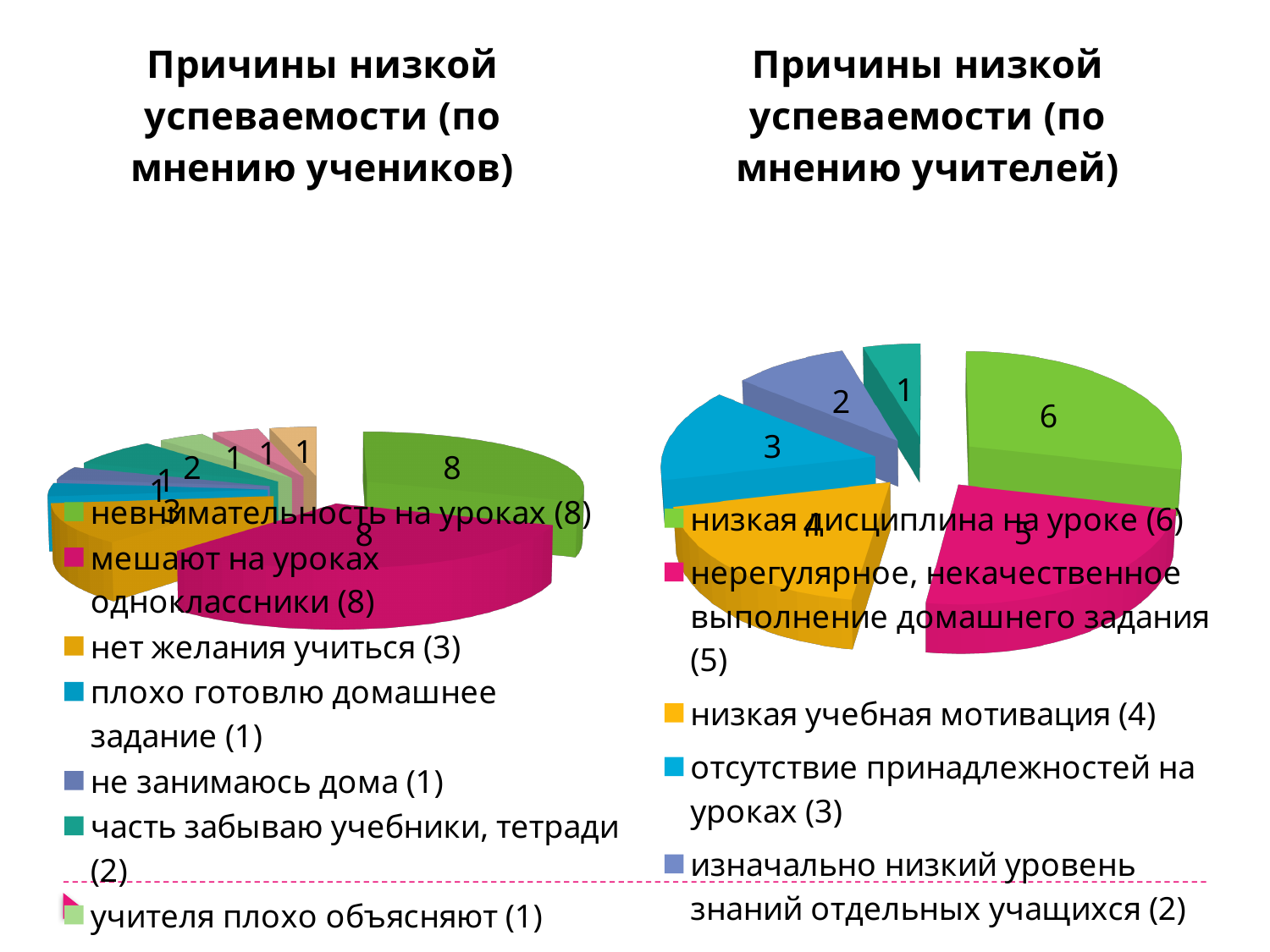
What is the title of the chart on the left side of the slide? Причины низкой успеваемости (по мнению учеников) In the chart titled 'Причины низкой успеваемости (по мнению учителей)', what is the difference between 'низкая дисциплина на уроке' and 'отсутствие принадлежностей на уроках'? 3 What kind of chart is the chart on the right side of the slide? pie chart In the chart titled 'Причины низкой успеваемости (по мнению учеников)', what is the difference between 'невнимательность на уроках' and 'нет желания учиться'? 5 In the chart titled 'Причины низкой успеваемости (по мнению учителей)', which category has the highest value? низкая дисциплина на уроке In the chart titled 'Причины низкой успеваемости (по мнению учеников)', which two categories share the highest value? невнимательность на уроках and мешают на уроках одноклассники In the chart titled 'Причины низкой успеваемости (по мнению учителей)', what is the value for 'низкая учебная мотивация'? 4 In the chart titled 'Причины низкой успеваемости (по мнению учителей)', what is the value for 'изначально низкий уровень знаний отдельных учащихся'? 2 In the chart titled 'Причины низкой успеваемости (по мнению учителей)', which is larger: 'нерегулярное, некачественное выполнение домашнего задания' or 'отсутствие принадлежностей на уроках'? нерегулярное, некачественное выполнение домашнего задания In the chart titled 'Причины низкой успеваемости (по мнению учеников)', what is the value for 'нет желания учиться'? 3 In the chart titled 'Причины низкой успеваемости (по мнению учеников)', what is the value for 'часть забываю учебники, тетради'? 2 In the chart titled 'Причины низкой успеваемости (по мнению учеников)', which is larger: 'нет желания учиться' or 'не занимаюсь дома'? нет желания учиться